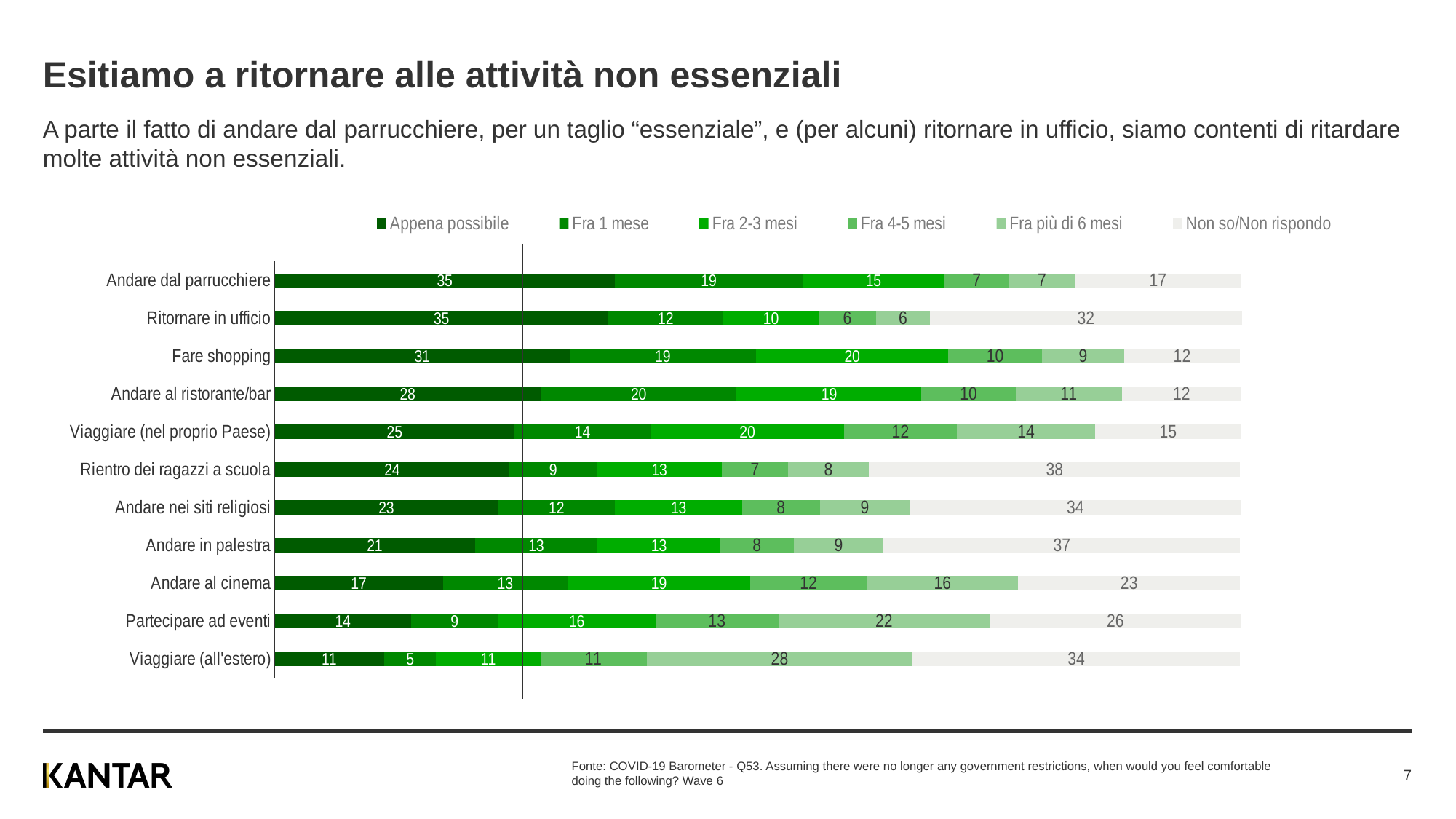
How many series does the legend list? 6 What is the difference between the "Appena possibile" values for Fare shopping and Andare al cinema? 14 What is the value for "Fra più di 6 mesi" for Viaggiare (all'estero)? 28 What kind of chart is shown on the slide? Stacked bar chart What is the value for "Fra 2-3 mesi" for Andare al cinema? 19 Which activity has the highest value for "Non so/Non rispondo"? Rientro dei ragazzi a scuola What is the value for "Appena possibile" for Fare shopping? 31 What is the total of the stacked bar for Andare dal parrucchiere? 100 How many activities are listed on the chart? 11 Which has the larger "Fra più di 6 mesi" value: Partecipare ad eventi or Andare al cinema? Partecipare ad eventi What is the value for "Non so/Non rispondo" for Rientro dei ragazzi a scuola? 38 Which activity has the lowest value for "Appena possibile"? Viaggiare (all'estero)